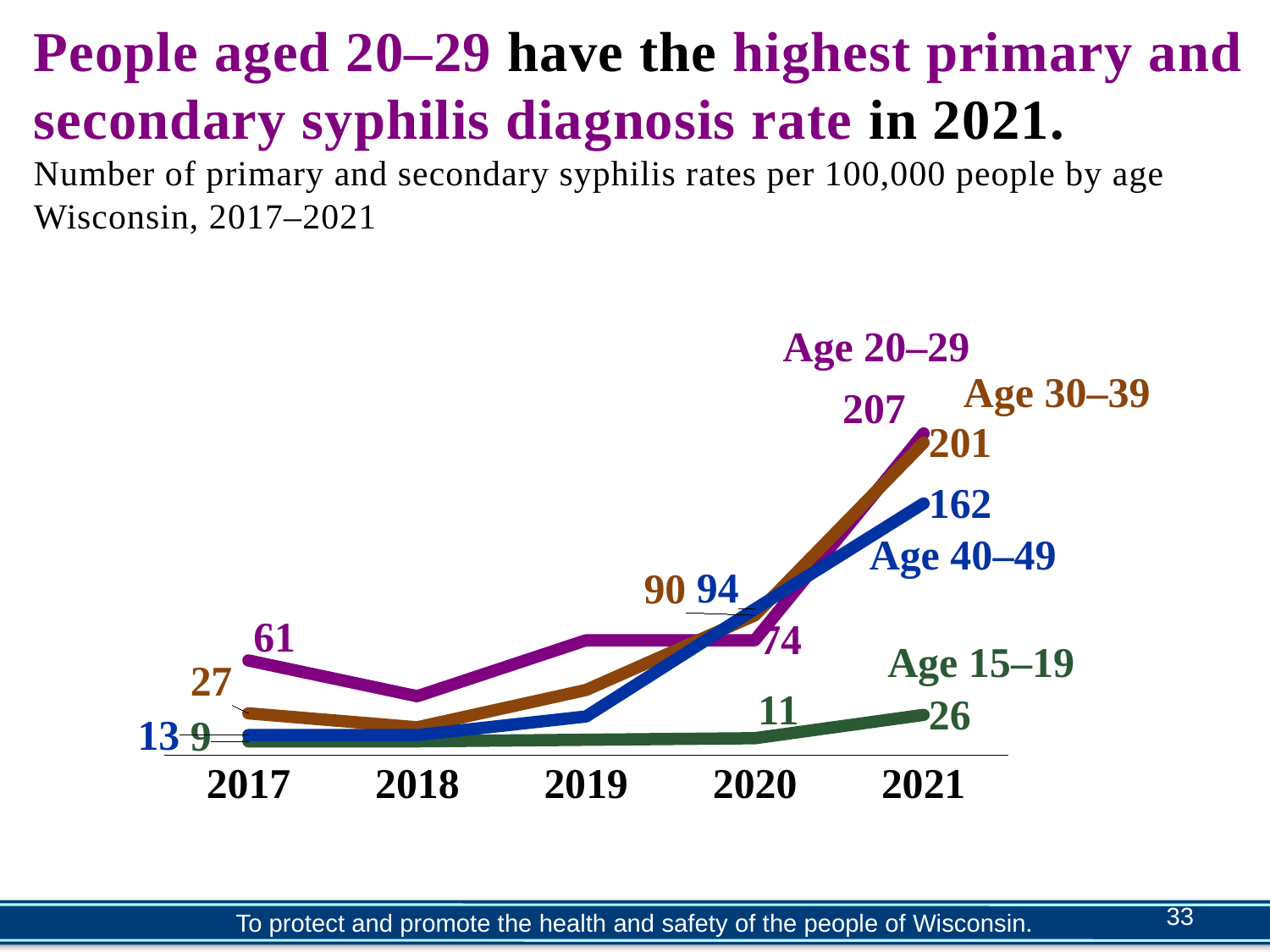
How many years are shown along the x axis? 5 What is the syphilis rate for Age 40–49 in 2021? 162 What is the syphilis rate for Age 30–39 in 2021? 201 By how much did the rate for Age 20–29 increase from 2017 to 2021? 146 What is the syphilis rate for Age 15–19 in 2017? 9 What kind of chart is shown on the slide? line chart Which age group has the lowest rate in 2021? Age 15–19 Which age group has the highest rate in 2021? Age 20–29 How many age groups (series) are plotted on the chart? 4 What is the syphilis rate for Age 20–29 in 2021? 207 In 2020, which had the higher rate: Age 40–49 or Age 30–39? Age 40–49 Does the rate for Age 15–19 rise or fall from 2017 to 2021? rise